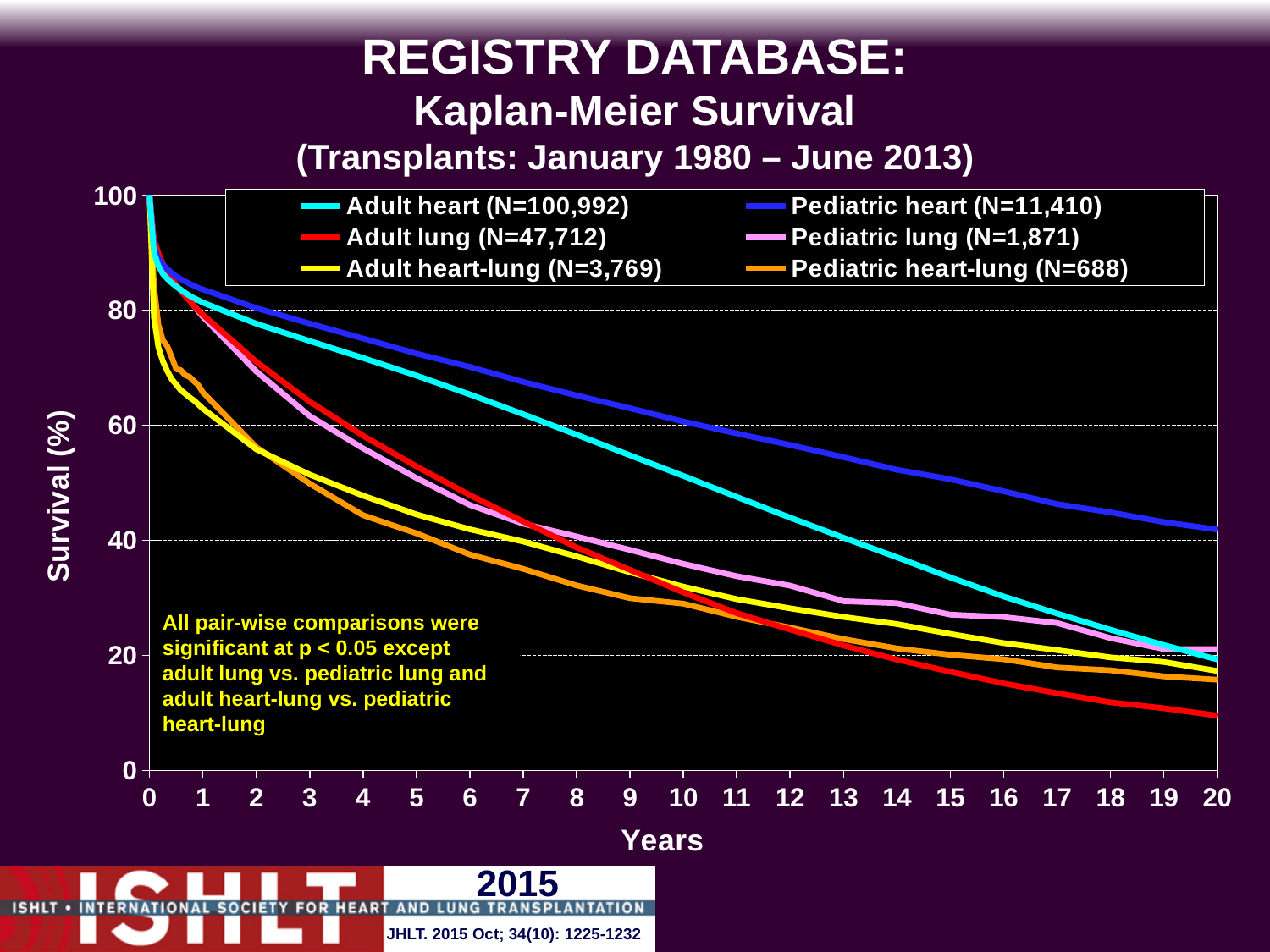
Is the survival for Pediatric heart at 20 years greater or less than 40? greater Is the survival for Adult heart-lung at 10 years greater or less than 40? less Is the survival for Adult heart at 5 years greater or less than 60? greater According to the legend, what is the N for Adult heart? N=100,992 Do the survival curves rise or fall as the years increase? Fall What kind of chart is shown on the slide? Line chart How many series does the legend list? 6 According to the legend, what is the N for Pediatric heart-lung? N=688 Which series has the highest survival at 20 years? Pediatric heart Which series has the lowest survival at 20 years? Adult lung At 10 years, which has higher survival: Adult heart or Adult lung? Adult heart